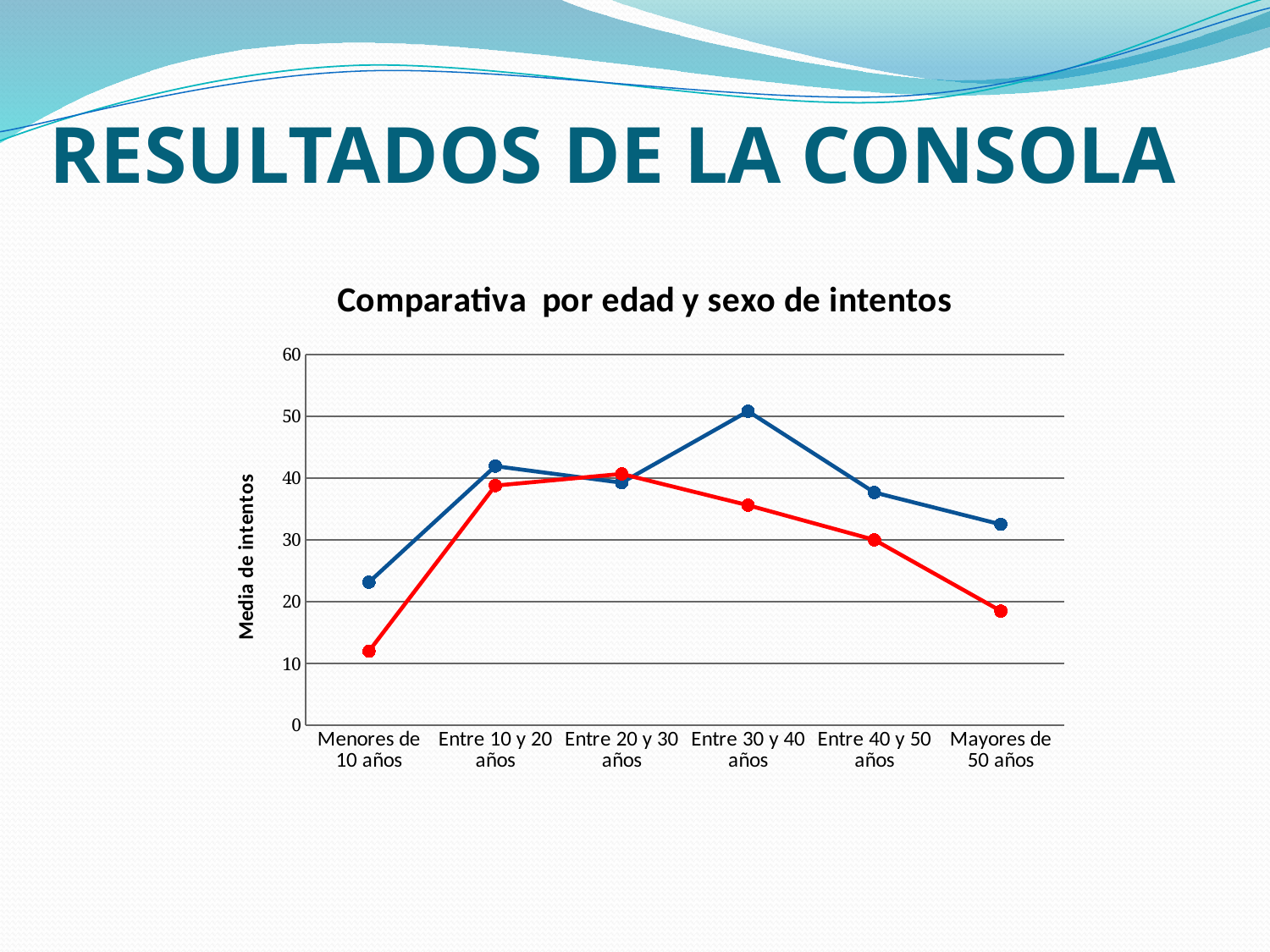
Is the value of the red line for Menores de 10 años greater or less than 20? less What is the label of the vertical axis? Media de intentos For which age category does the red line have its lowest value? Menores de 10 años For which age category does the blue line have its lowest value? Menores de 10 años For which age category does the blue line reach its highest value? Entre 30 y 40 años How many age categories are shown on the x axis? 6 What kind of chart is shown on the slide? line chart Does the red line rise or fall from Entre 20 y 30 años to Mayores de 50 años? fall What is the title of the chart? Comparativa por edad y sexo de intentos Is the value of the blue line for Entre 30 y 40 años greater or less than 40? greater How many lines (series) are plotted on the chart? 2 For Mayores de 50 años, which line has the higher value, the blue or the red? blue